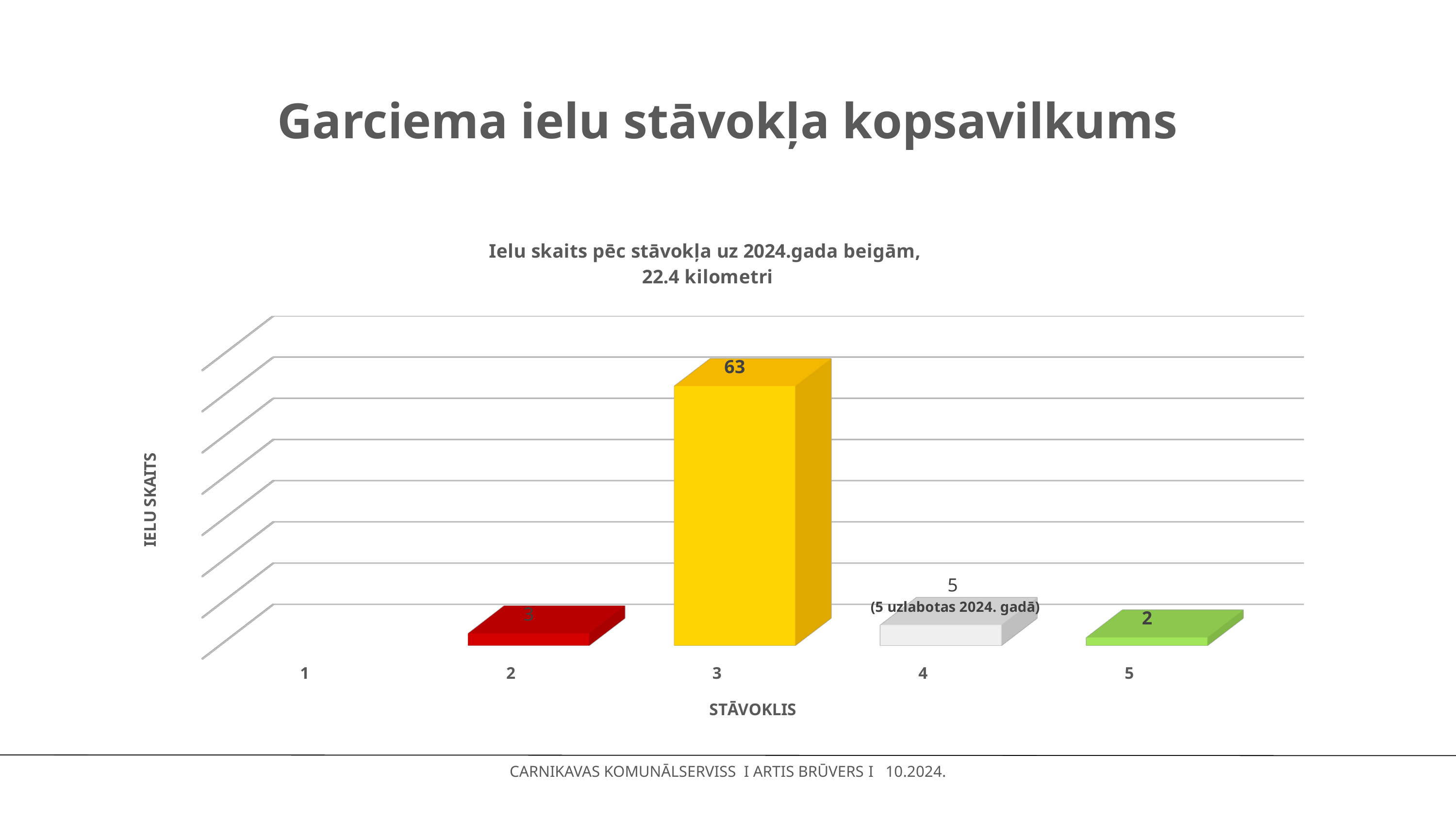
How many condition categories are shown on the x axis? 5 What colour is the bar for condition 3? yellow What is the value for condition 2? 3 What is the value for condition (STĀVOKLIS) 3? 63 Which is larger, the value for condition 2 or the value for condition 4? condition 4 What kind of chart is shown on the slide? bar chart What is the difference between the values for condition 3 and condition 4? 58 What is the title of the chart? Ielu skaits pēc stāvokļa uz 2024.gada beigām, 22.4 kilometri Which condition category has the highest number of streets? 3 What is the value for condition 4? 5 What is the value for condition 5? 2 What is the difference between the values for condition 4 and condition 5? 3